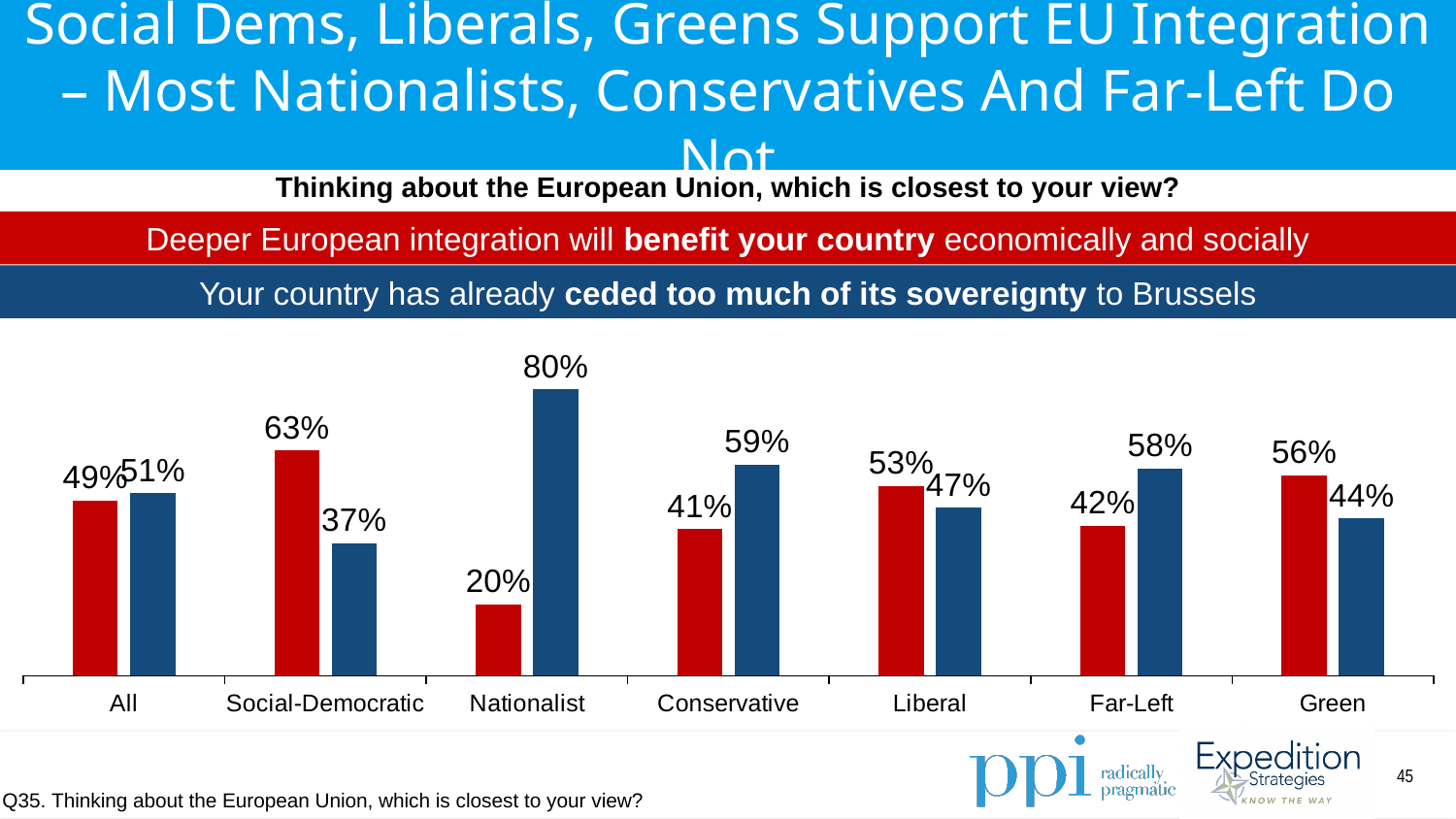
What type of chart is shown on the slide? Bar chart Which colour represents the view that deeper European integration will benefit your country? Red Among Conservative respondents, which is larger: the share saying integration will benefit their country or the share saying too much sovereignty has been ceded? Too much sovereignty has been ceded (59%) Which group has the lowest share saying deeper European integration will benefit their country? Nationalist What is the difference between the share of Nationalists saying too much sovereignty has been ceded and the share saying integration will benefit their country? 60 percentage points What percentage of Liberal respondents say deeper European integration will benefit their country? 53% How many respondent groups are shown on the x axis of the chart? 7 What percentage of Green respondents say their country has already ceded too much sovereignty to Brussels? 44% Which group has the highest share saying deeper European integration will benefit their country? Social-Democratic How many response options (series) does the chart plot for each group? 2 What percentage of Nationalist respondents say their country has already ceded too much of its sovereignty to Brussels? 80% What percentage of Social-Democratic respondents say deeper European integration will benefit their country? 63%